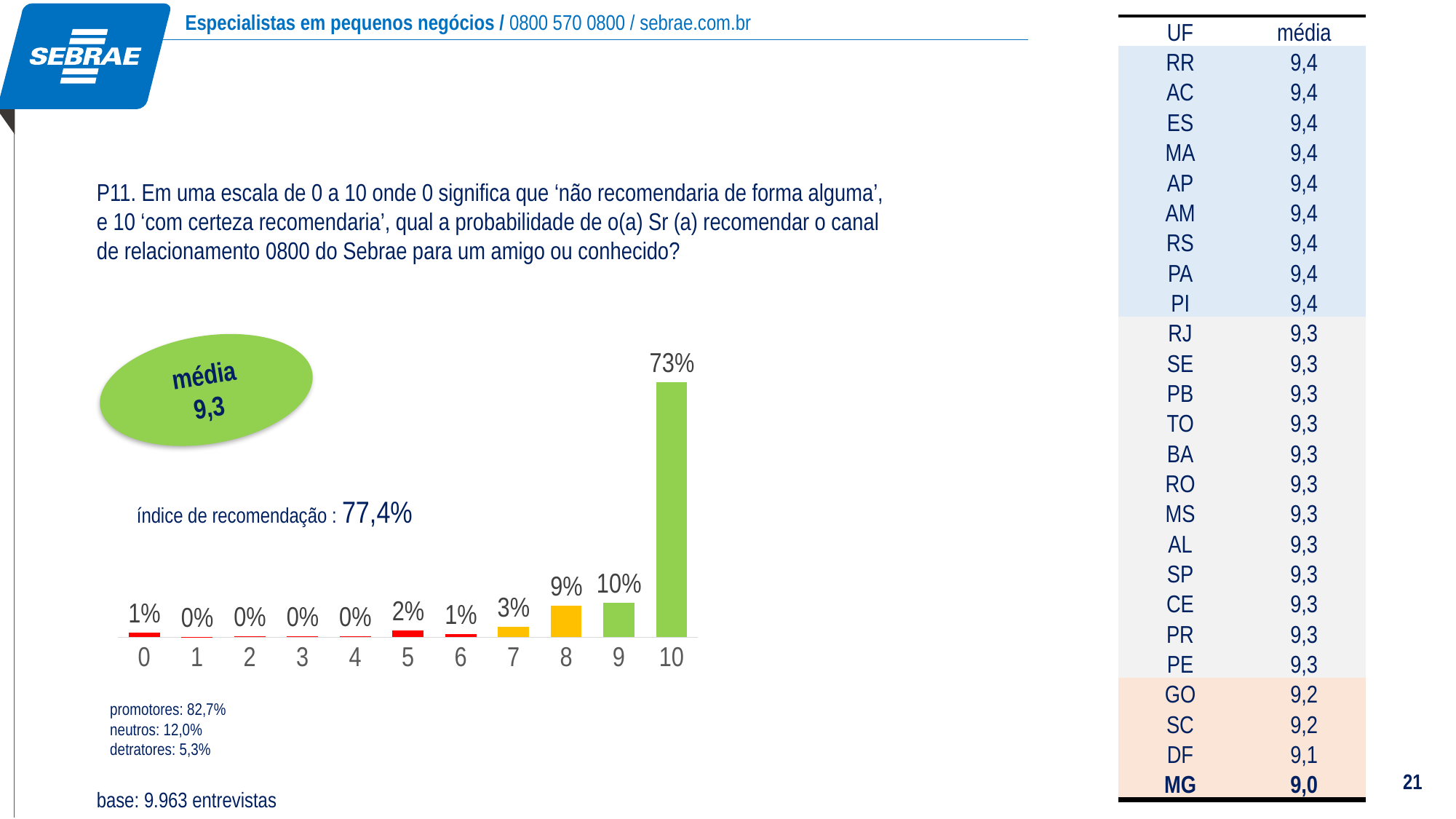
What colour are the bars for scores 9 and 10? green What percentage of respondents gave a score of 8? 9% Which score has the highest percentage of respondents? 10 How many score categories are shown on the x axis of the chart? 11 Which is larger, the value for score 8 or the value for score 7? score 8 What is the difference in percentage points between the bars for score 10 and score 9? 63 What percentage of respondents gave a score of 5? 2% What kind of chart is used to show the distribution of scores? bar chart What percentage of respondents gave a score of 7? 3% What is the combined percentage for scores 9 and 10? 83% What percentage of respondents gave a score of 9? 10% What percentage of respondents gave a score of 10? 73%